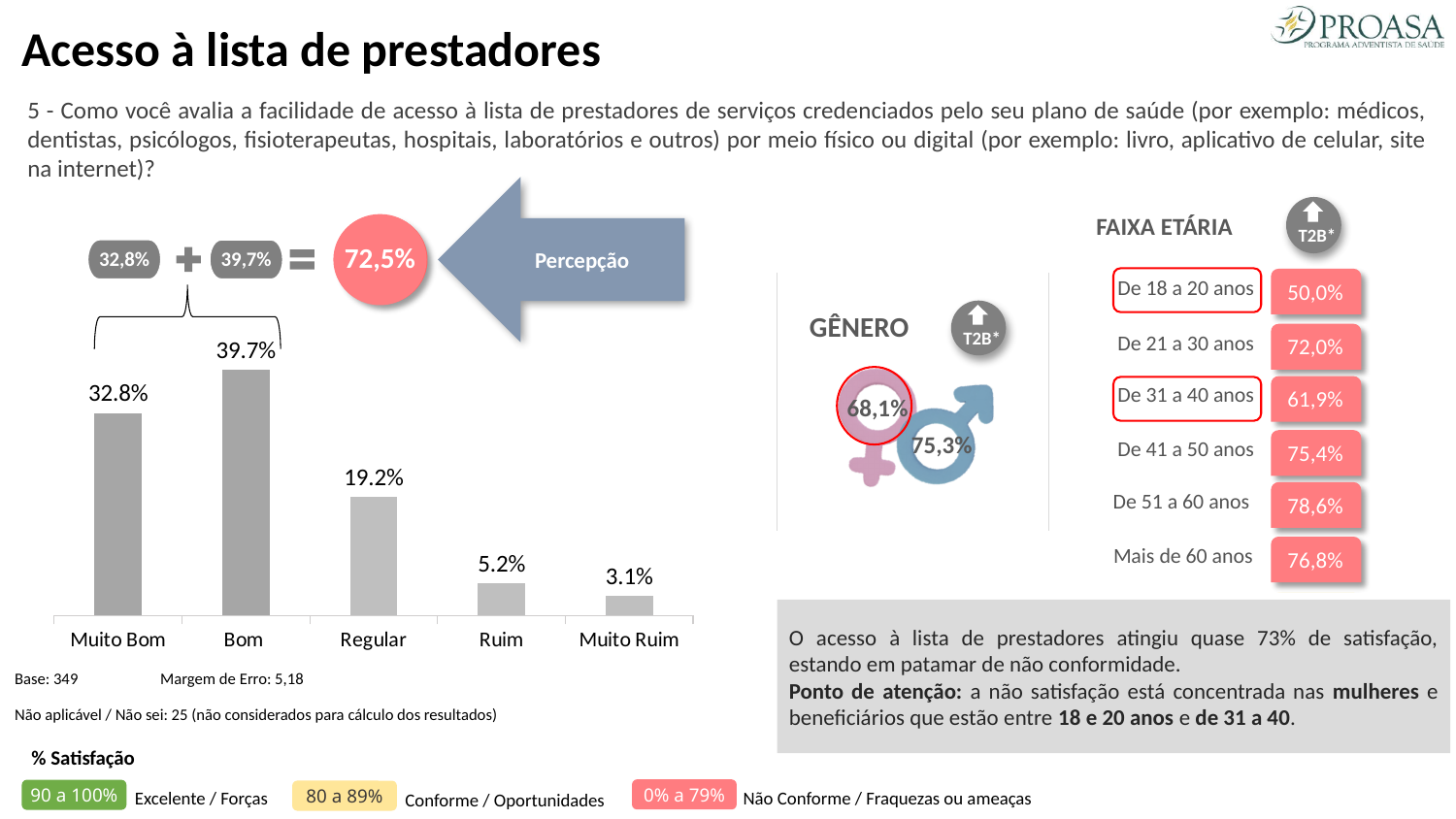
What is the combined value of Muito Bom and Bom shown in the circle above the bar chart? 72,5% Which category has the lowest value in the bar chart? Muito Ruim What is the value for Muito Bom in the bar chart? 32.8% What is the value for Bom in the bar chart? 39.7% What is the difference between the values for Ruim and Muito Ruim in the bar chart? 2.1% Which category has the highest value in the bar chart? Bom What is the difference between the values for Bom and Muito Bom in the bar chart? 6.9% What kind of chart is used to show the ratings from Muito Bom to Muito Ruim? Bar chart How many categories are shown in the bar chart? 5 Which is larger in the bar chart, Regular or Ruim? Regular What is the value for Regular in the bar chart? 19.2% What is the value for Muito Ruim in the bar chart? 3.1%